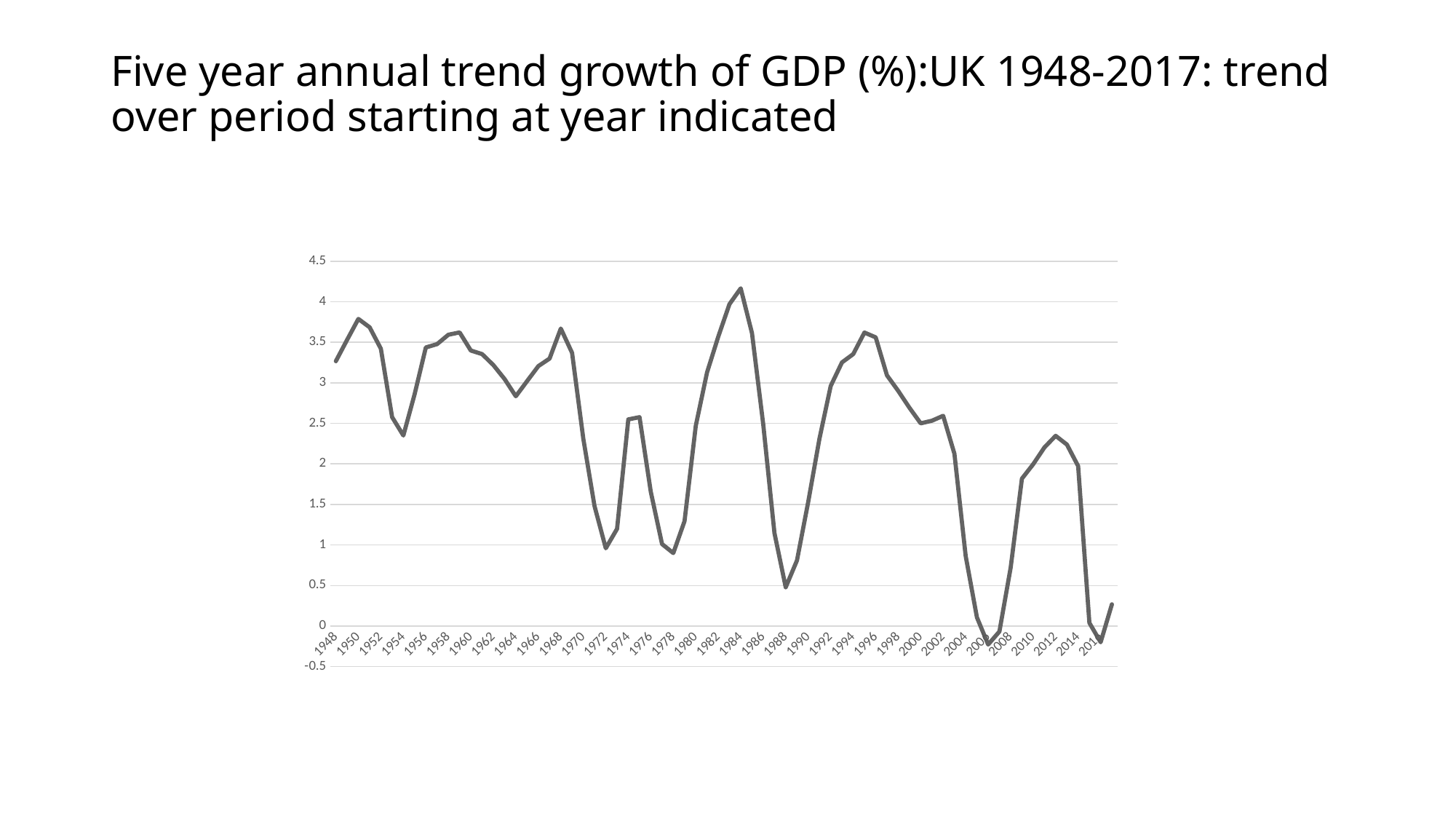
In which year does the five year trend growth of GDP reach its highest value? 1984 Is the value for 1988 greater or less than 1? less Is the value for 1972 greater or less than 1.5? less Does the value rise or fall between 1984 and 1988? fall Is the value for 2012 greater or less than 2? greater Which year has the larger value, 1954 or 1960? 1960 What kind of chart is shown on the slide? line chart Which year has the larger value, 1984 or 1972? 1984 What is the title of the chart on the slide? Five year annual trend growth of GDP (%):UK 1948-2017: trend over period starting at year indicated